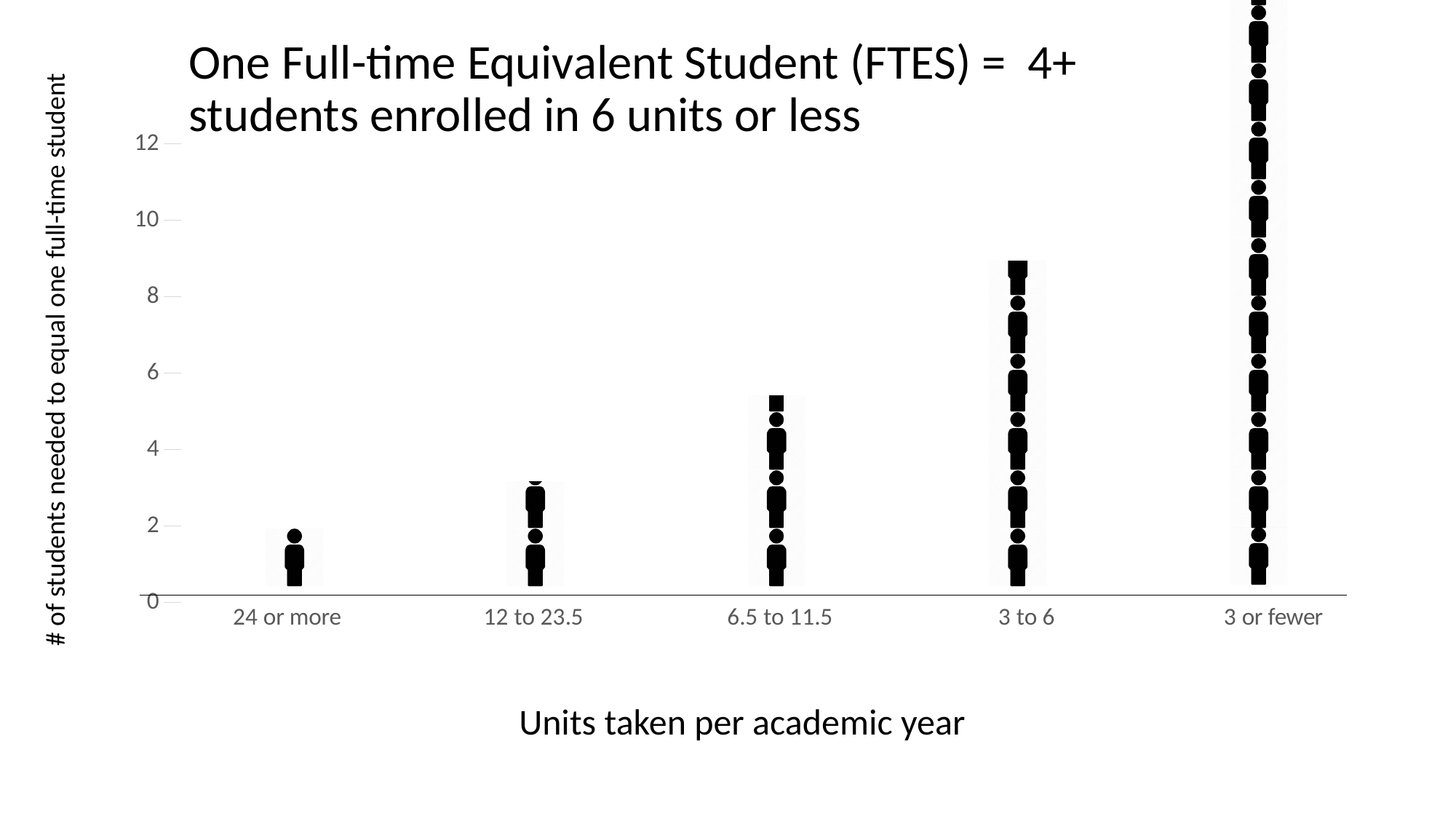
Is the value for 3 to 6 greater or less than 8? greater Which category has the lowest value? 24 or more Is the value for 12 to 23.5 greater or less than 4? less Do the values rise or fall moving from left to right along the x axis? rise Which is larger, the value for 3 to 6 or the value for 6.5 to 11.5? 3 to 6 What kind of chart is shown on the slide? bar chart Is the value for 3 to 6 greater or less than 10? less Which category has the highest value? 3 or fewer How many categories are shown on the x axis? 5 What is the title of the x axis? Units taken per academic year